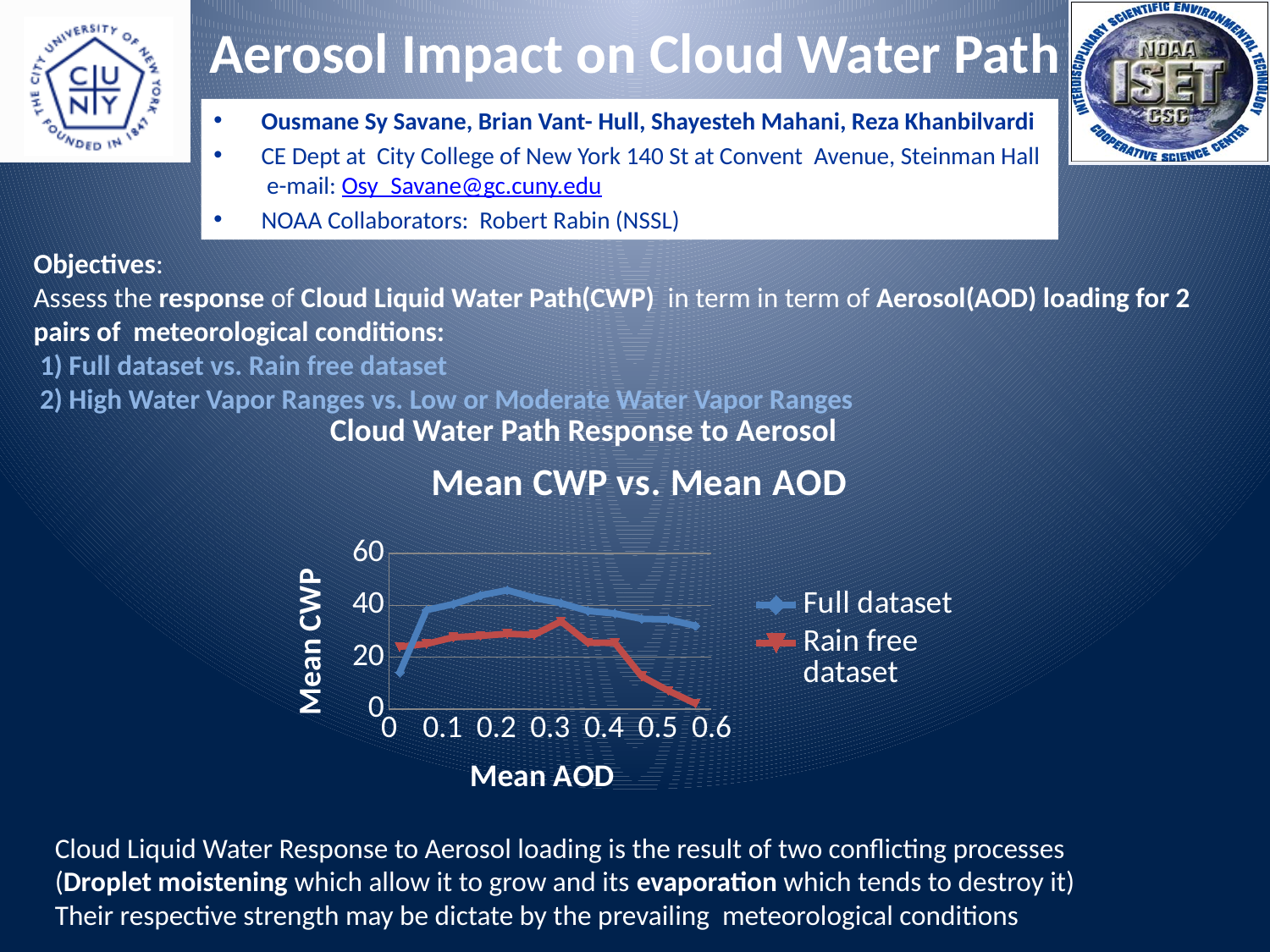
How many series does the legend of the chart list? 2 Does the Rain free dataset line rise or fall between Mean AOD 0.3 and 0.6? fall What is the title of the chart? Mean CWP vs. Mean AOD Is the Full dataset value at Mean AOD 0 greater or less than 20? less At Mean AOD 0, which series has the higher Mean CWP, Full dataset or Rain free dataset? Rain free dataset Is the Full dataset value at Mean AOD 0.4 greater or less than 40? less What are the two series named in the chart legend? Full dataset and Rain free dataset At Mean AOD 0.5, which series has the higher Mean CWP, Full dataset or Rain free dataset? Full dataset What kind of chart is shown on the slide? line chart Is the Rain free dataset value at Mean AOD 0.5 greater or less than 20? less Does the Full dataset line rise or fall between Mean AOD 0 and 0.2? rise